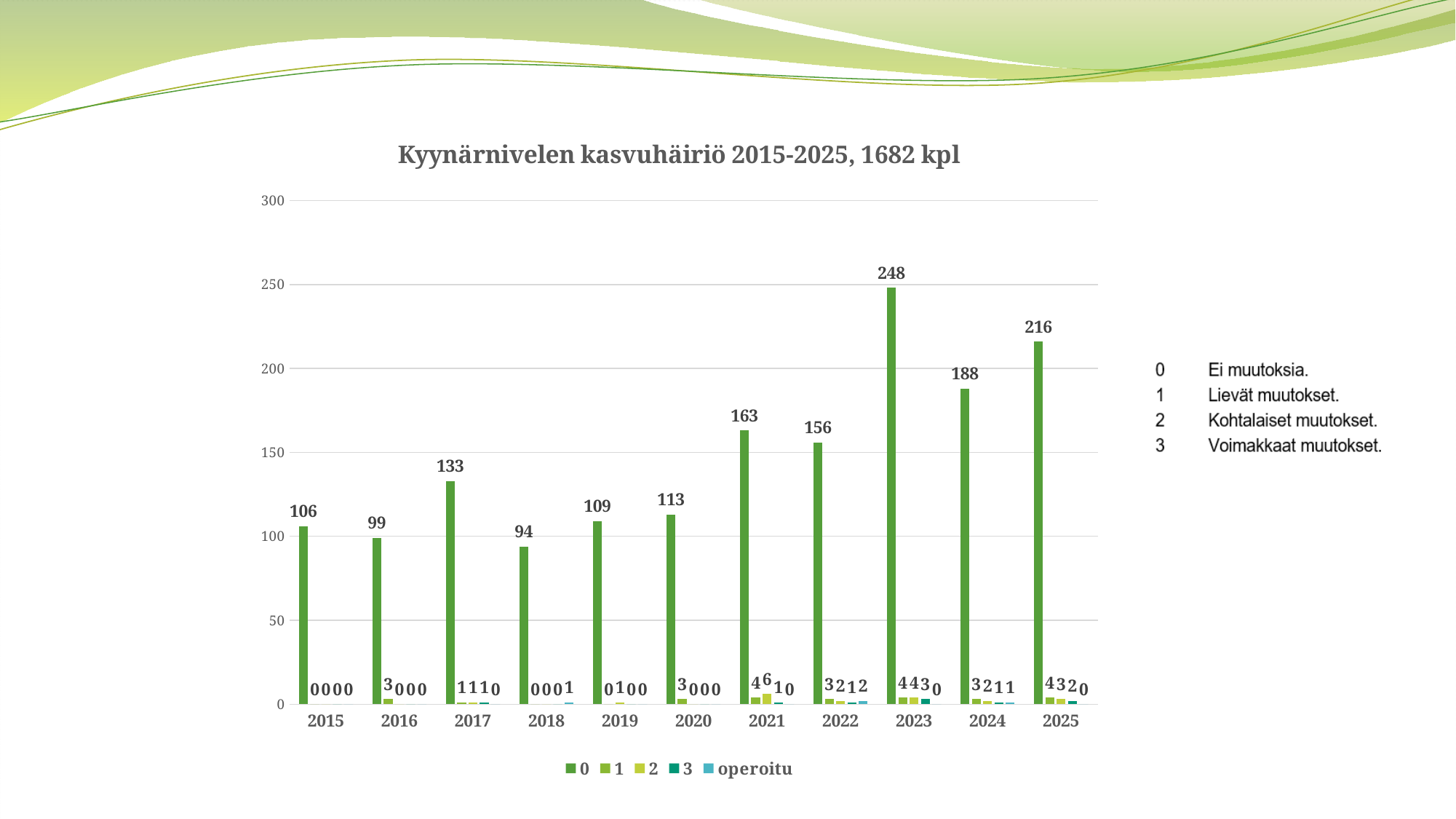
What is the value of series 0 for 2025? 216 What is the title of the chart? Kyynärnivelen kasvuhäiriö 2015-2025, 1682 kpl How many years are shown on the x axis? 11 How many series does the legend list? 5 What kind of chart is shown on the slide? bar chart What is the value of series 0 for 2018? 94 Which year has the highest value for series 0? 2023 Which is larger for series 0: the value for 2021 or the value for 2022? 2021 Which year has the lowest value for series 0? 2018 What is the difference between the series 0 values for 2023 and 2024? 60 What is the difference between the series 0 values for 2017 and 2016? 34 What is the value of series 0 for 2023? 248